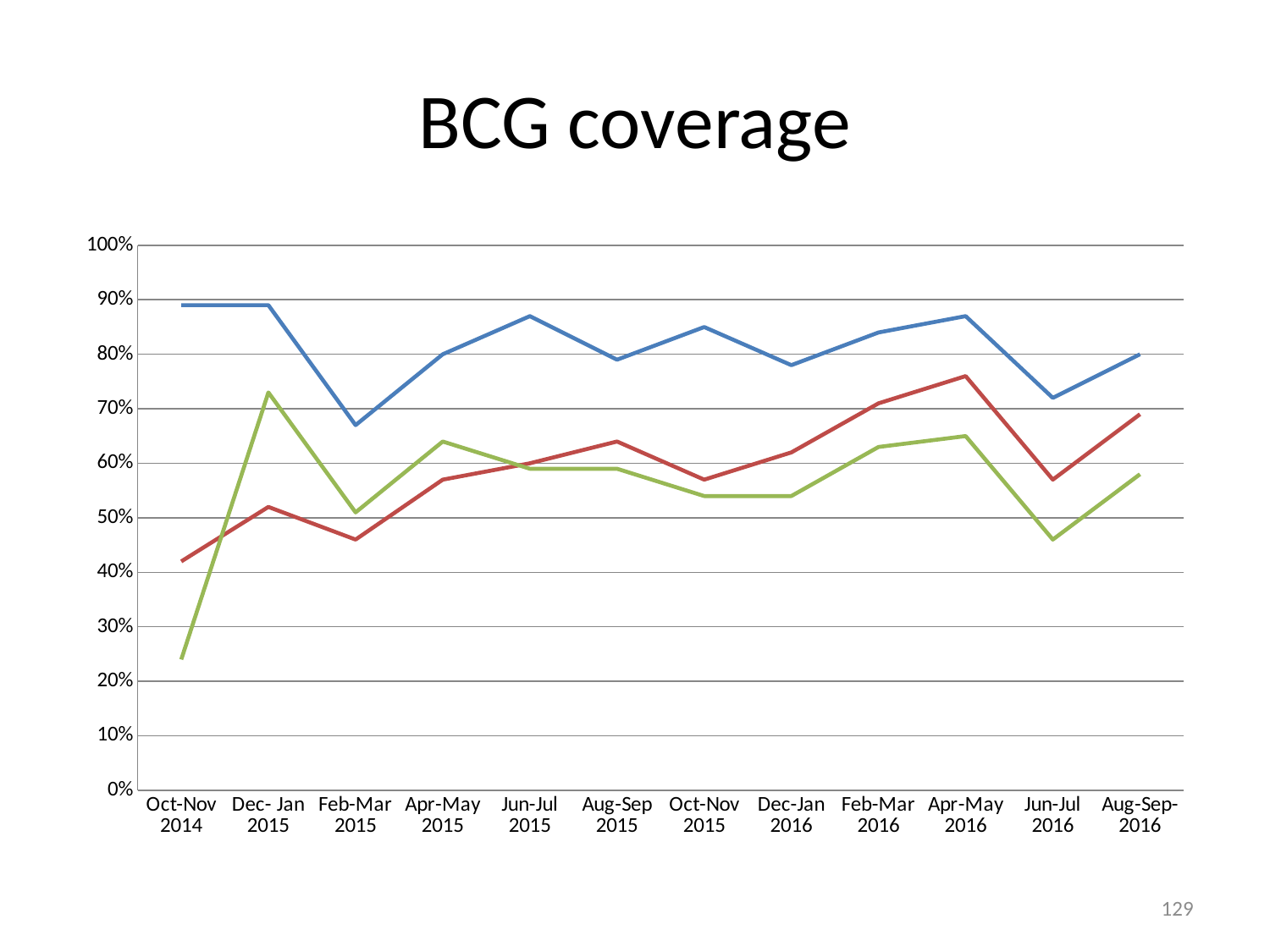
In which period is the green line at its lowest? Oct-Nov 2014 What kind of chart is shown on the slide? Line chart Is the value of the green line for Oct-Nov 2014 greater or less than 30%? less Is the value of the blue line for Oct-Nov 2014 greater or less than 80%? greater What is the title of the chart? BCG coverage In which period is the red line at its highest? Apr-May 2016 At Dec-Jan 2015, which is higher, the green line or the red line? Green line In which period is the blue line at its lowest? Feb-Mar 2015 How many lines are plotted on the chart? 3 Is the value of the red line for Apr-May 2016 greater or less than 70%? greater How many time periods are shown on the x axis? 12